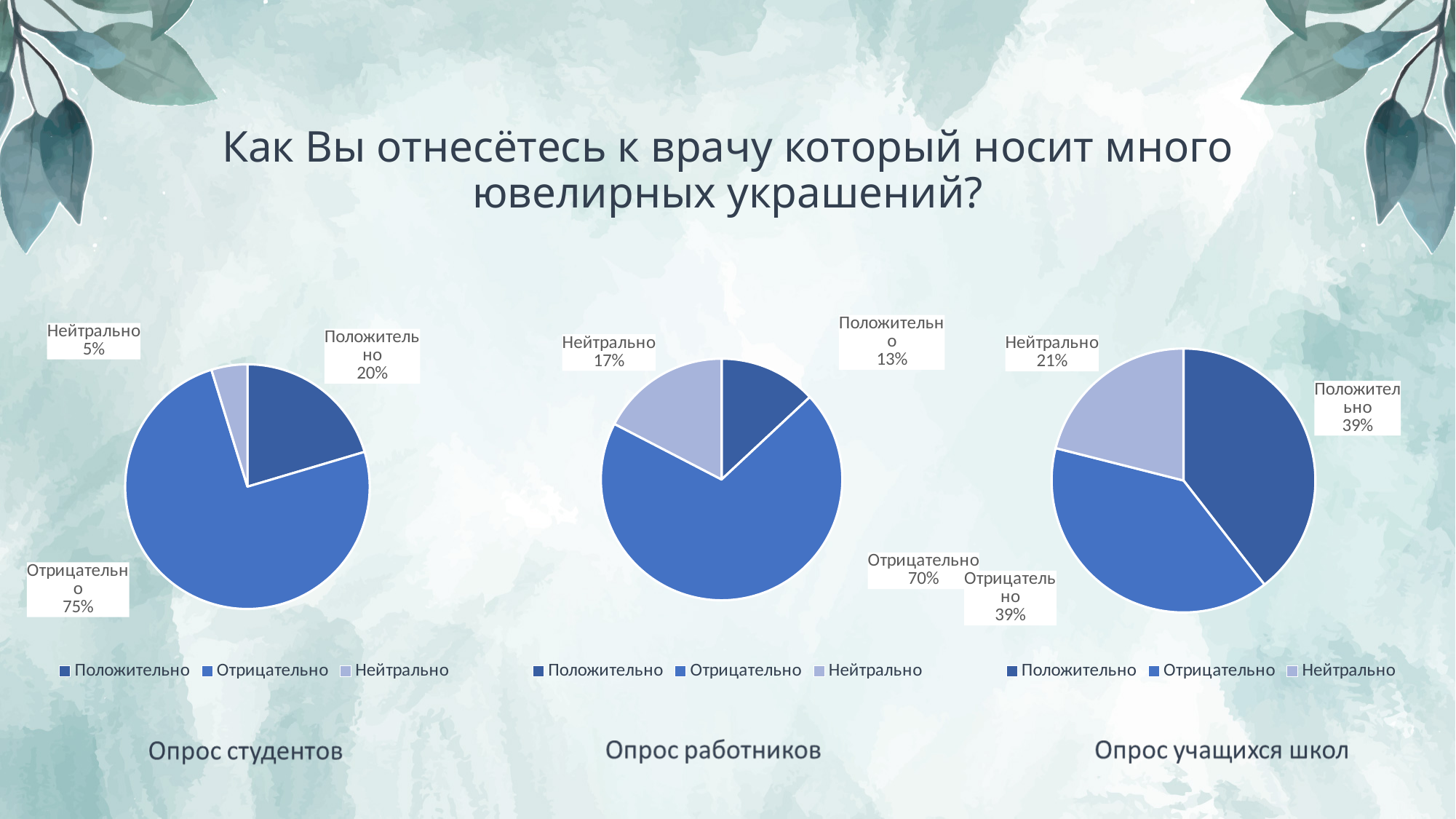
In the 'Опрос студентов' chart, what share of respondents answered 'Отрицательно'? 75% In the 'Опрос работников' chart, what share of respondents answered 'Положительно'? 13% In the 'Опрос студентов' chart, what share of respondents answered 'Нейтрально'? 5% How many entries does the legend of the 'Опрос студентов' chart list? 3 Which is larger in the 'Опрос работников' chart: the 'Нейтрально' share or the 'Положительно' share? Нейтрально What type of chart is used for 'Опрос учащихся школ'? Pie chart In the 'Опрос учащихся школ' chart, what share of respondents answered 'Нейтрально'? 21% In the 'Опрос работников' chart, what share of respondents answered 'Нейтрально'? 17% In the 'Опрос студентов' chart, which response has the largest share? Отрицательно In the 'Опрос студентов' chart, what is the difference between the 'Отрицательно' and 'Положительно' shares? 55% In the 'Опрос работников' chart, which response has the smallest share? Положительно In the 'Опрос учащихся школ' chart, which response has the smallest share? Нейтрально